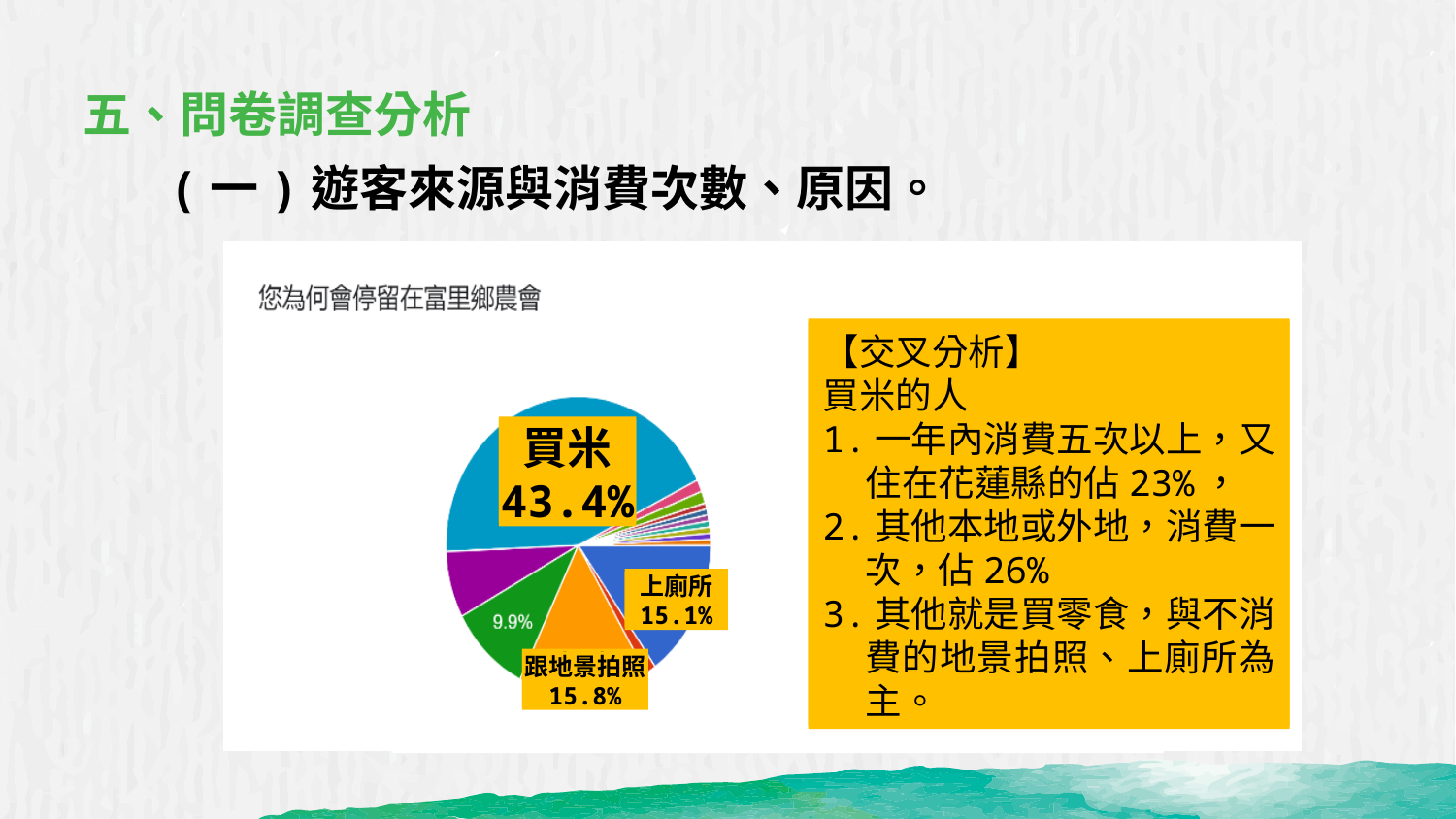
Which is larger, 跟地景拍照 or 上廁所? 跟地景拍照 What is the title of the pie chart? 您為何會停留在富里鄉農會 What is the value shown for 上廁所? 15.1% Which category has the largest slice of the pie? 買米 Which is larger, the 買米 slice or the 跟地景拍照 slice? 買米 What percentage of the pie does 買米 account for? 43.4% What is the difference between the 跟地景拍照 slice and the 上廁所 slice? 0.7% What is the value shown for 跟地景拍照? 15.8% What is the difference between the 買米 slice and the 跟地景拍照 slice? 27.6% What is the difference between the 買米 slice and the 上廁所 slice? 28.3% What type of chart is shown on the slide? pie chart